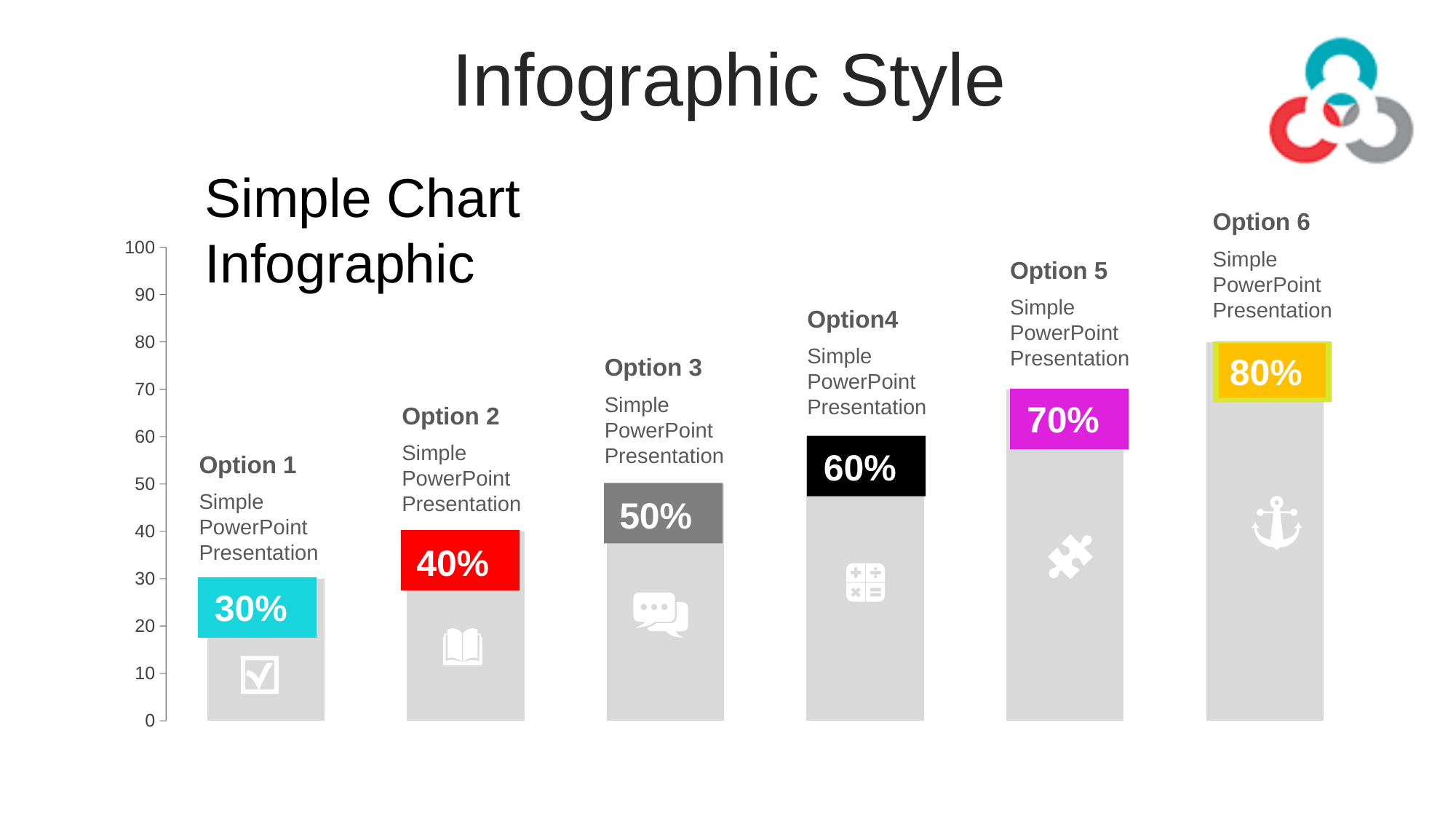
What is the value shown for Option 6? 80% What is the title of the chart? Simple Chart Infographic Do the values rise or fall from Option 1 to Option 6? rise What is the difference between the values for Option 5 and Option 2? 30% Which option has the highest value? Option 6 What is the value shown for Option 1? 30% Which is larger, the value for Option 3 or the value for Option 4? Option 4 Which option has the lowest value? Option 1 What is the value shown for Option 4? 60% What kind of chart is shown on the slide? bar chart Is the value for Option 2 greater or less than 50? less How many options (bars) are shown in the chart? 6